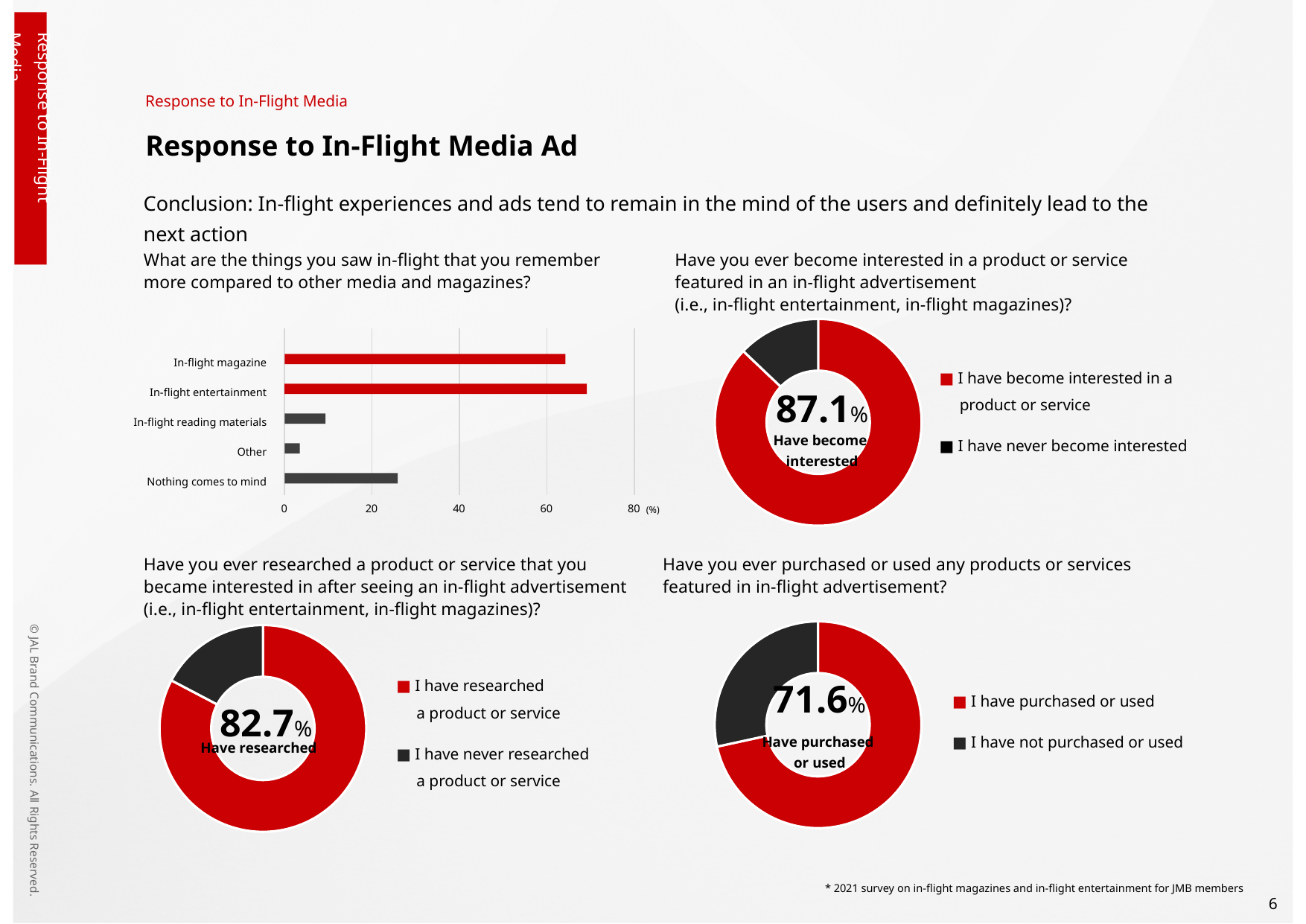
In the bottom-right donut chart, how many entries does the legend list? 2 In the top-left bar chart, is the value for In-flight magazine greater or less than 60? greater In the top-left bar chart, is the value for In-flight reading materials greater or less than 20? less In the top-left bar chart, which is larger: the value for Nothing comes to mind or the value for In-flight reading materials? Nothing comes to mind What kind of chart is the top-left chart about things remembered in-flight? bar chart In the bottom-left donut chart, what percentage of respondents have researched a product or service? 82.7% In the top-left bar chart, is the value for Nothing comes to mind greater or less than 40? less In the top-left bar chart, which category has the lowest value? Other In the top-left bar chart, which category has the highest value? In-flight entertainment In the top-left bar chart, how many categories are shown? 5 In the bottom-right donut chart, what percentage of respondents have purchased or used products or services featured in in-flight advertisement? 71.6% In the top-right donut chart, what percentage of respondents have become interested in a product or service featured in an in-flight advertisement? 87.1%